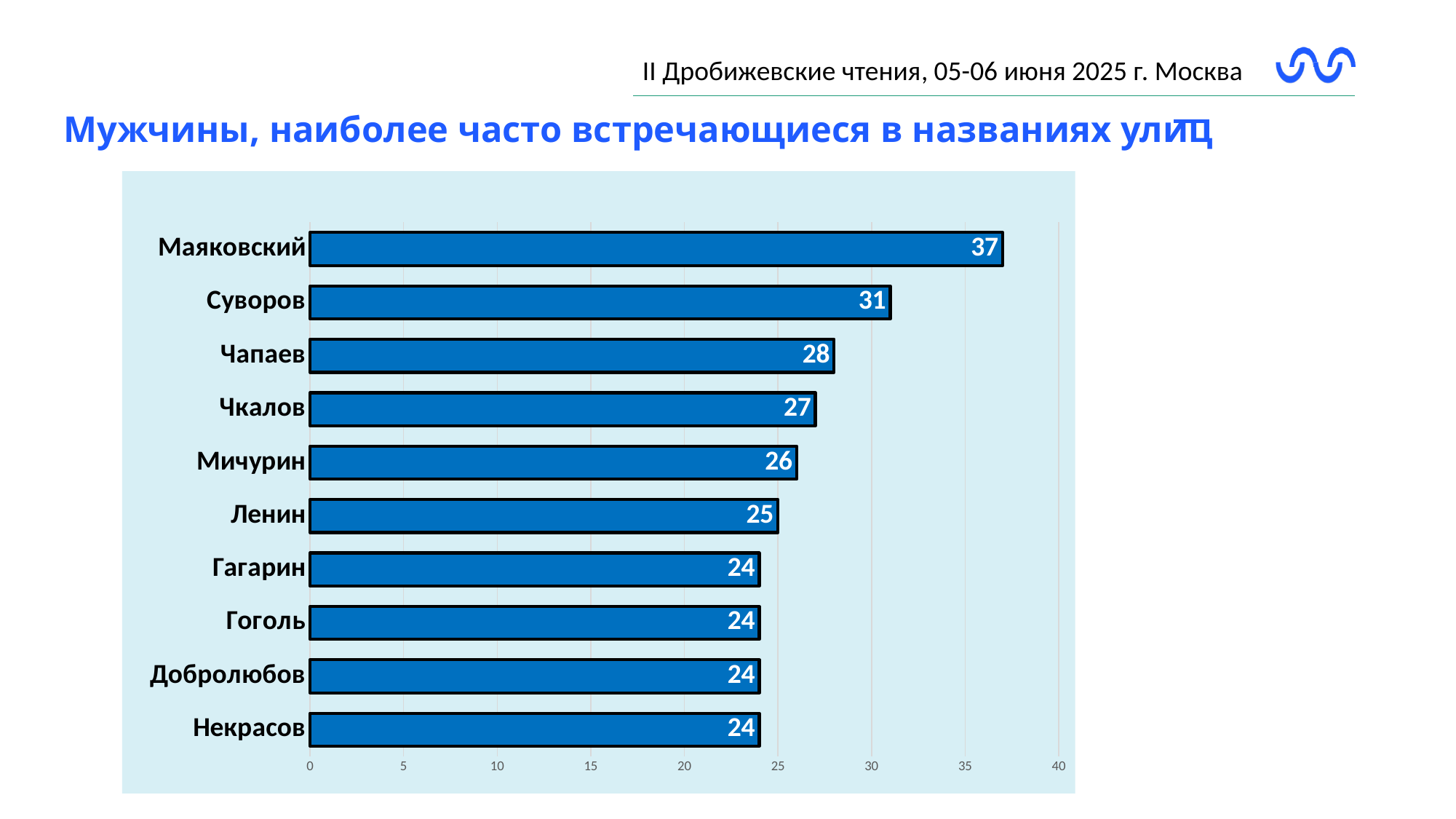
Which is larger, the value for Суворов or the value for Мичурин? Суворов Which category has the highest value? Маяковский Is the value for Гагарин greater or less than 30? less What is the value for Ленин? 25 How many categories have a value of 24? 4 What is the difference between the values for Чапаев and Некрасов? 4 What is the value for Маяковский? 37 How many categories are shown in the chart? 10 What is the difference between the values for Маяковский and Суворов? 6 What is the value for Чкалов? 27 What kind of chart is shown on the slide? bar chart Is the value for Маяковский greater or less than 35? greater